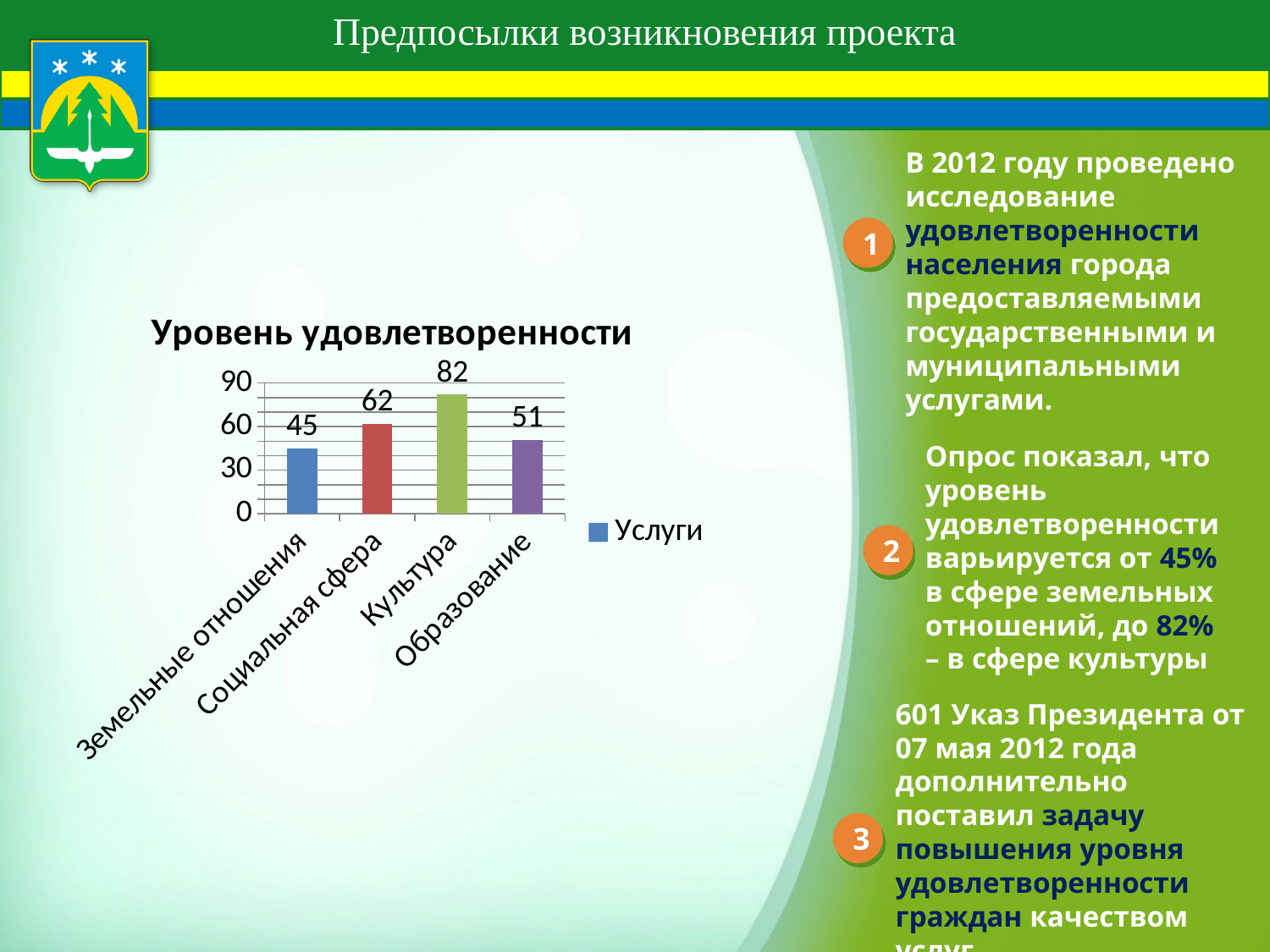
Which is larger, the value for Социальная сфера or the value for Образование? Социальная сфера What is the value for Образование in the chart? 51 What is the value for Земельные отношения in the chart? 45 What kind of chart is shown on the slide? bar chart How many series does the chart legend list? 1 What is the title of the chart? Уровень удовлетворенности Which category has the lowest value in the chart? Земельные отношения Which category has the highest value in the chart? Культура What is the value for Культура in the chart? 82 What is the difference between the values for Культура and Земельные отношения? 37 What is the value for Социальная сфера in the chart? 62 How many categories are shown in the chart? 4